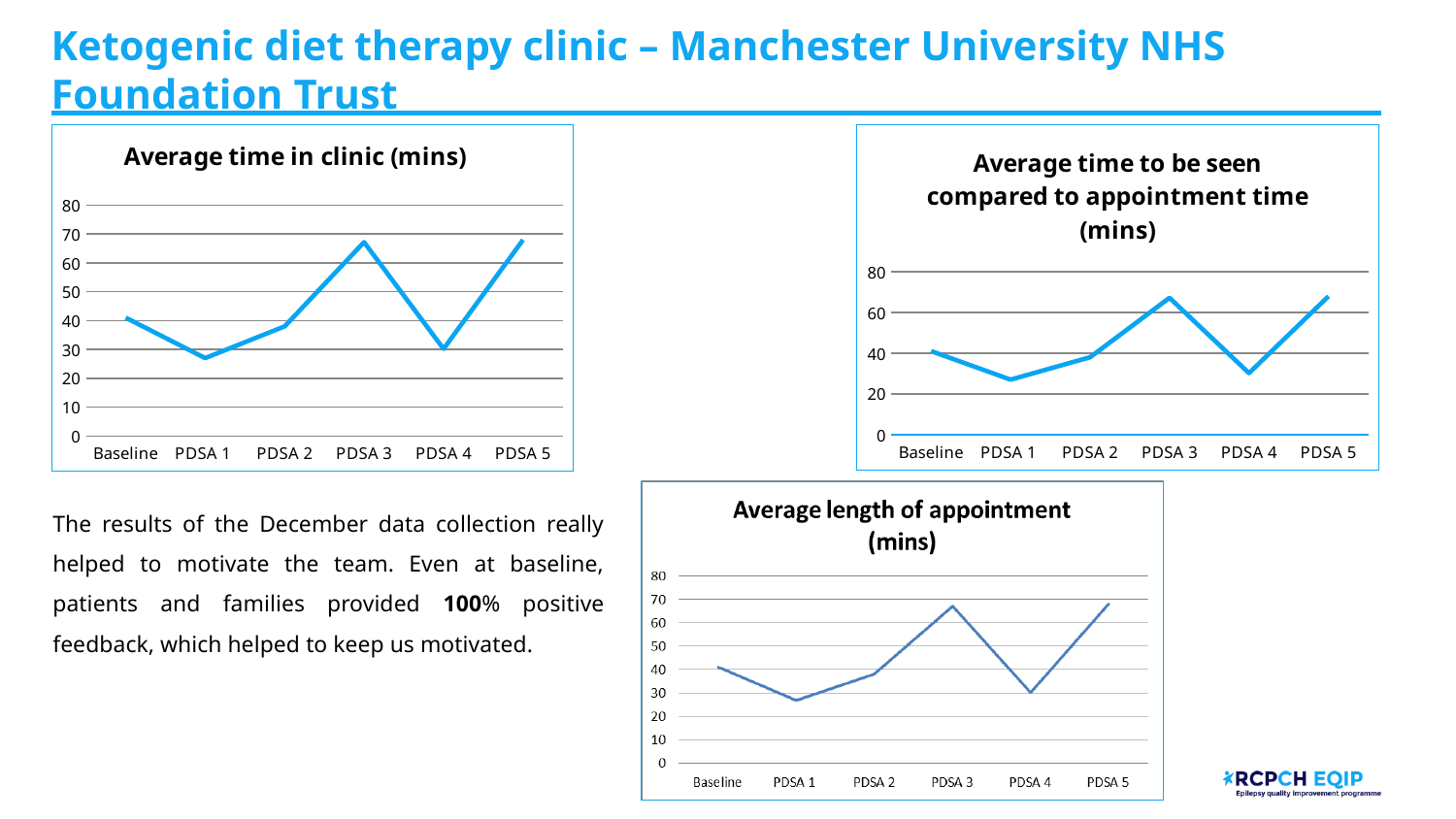
In the "Average time in clinic (mins)" chart, how many categories are plotted along the x axis? 6 In the "Average time in clinic (mins)" chart, is the value for PDSA 3 greater or less than 60? greater In the "Average time to be seen compared to appointment time (mins)" chart, is the value for Baseline greater or less than 60? less In the "Average time in clinic (mins)" chart, is the value for PDSA 1 greater or less than 30? less How many charts are shown on the slide? 3 In the "Average time to be seen compared to appointment time (mins)" chart, which category has the lowest value? PDSA 1 What type of chart is "Average time in clinic (mins)"? line chart In the "Average time to be seen compared to appointment time (mins)" chart, which is larger, the value for PDSA 3 or the value for PDSA 4? PDSA 3 In the "Average length of appointment (mins)" chart, does the value rise or fall from PDSA 4 to PDSA 5? rise In the "Average length of appointment (mins)" chart, which is larger, the value for Baseline or the value for PDSA 1? Baseline In the "Average time in clinic (mins)" chart, which category has the lowest value? PDSA 1